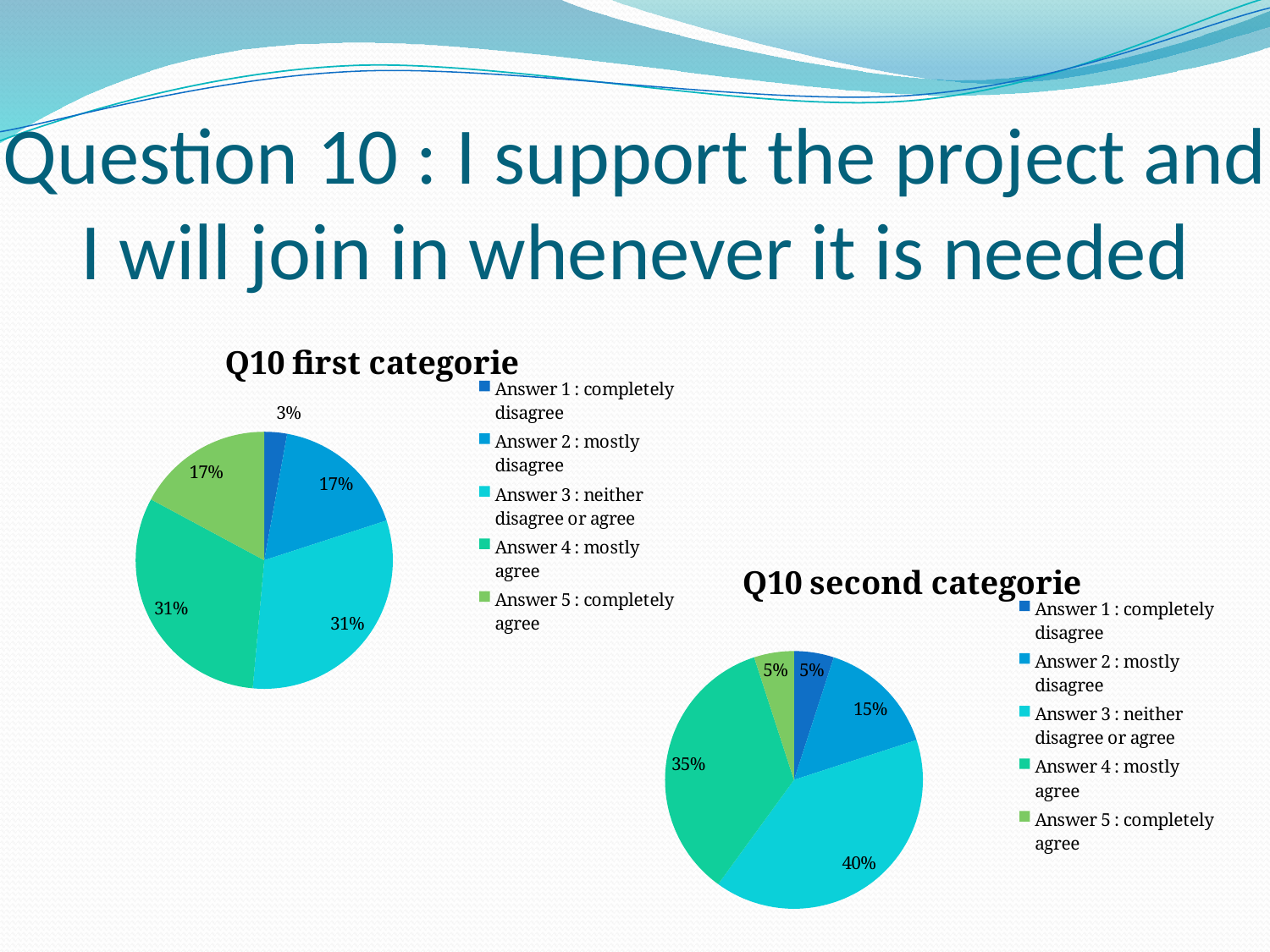
How many entries does the legend of the 'Q10 first categorie' chart list? 5 In the 'Q10 first categorie' chart, what share is shown for Answer 2 : mostly disagree? 17% In the 'Q10 first categorie' chart, which answer has the smallest share? Answer 1 : completely disagree What type of chart is 'Q10 second categorie'? Pie chart In the 'Q10 second categorie' chart, what share is shown for Answer 3 : neither disagree or agree? 40% In the 'Q10 first categorie' chart, which is larger: the share for Answer 2 : mostly disagree or the share for Answer 3 : neither disagree or agree? Answer 3 : neither disagree or agree In the 'Q10 second categorie' chart, what is the difference between the shares for Answer 3 : neither disagree or agree and Answer 4 : mostly agree? 5% In the 'Q10 second categorie' chart, which answer has the largest share? Answer 3 : neither disagree or agree In the 'Q10 second categorie' chart, what share is shown for Answer 4 : mostly agree? 35% In the 'Q10 second categorie' chart, what share is shown for Answer 2 : mostly disagree? 15% In the 'Q10 first categorie' chart, what share is shown for Answer 3 : neither disagree or agree? 31% In the 'Q10 first categorie' chart, what share is shown for Answer 1 : completely disagree? 3%